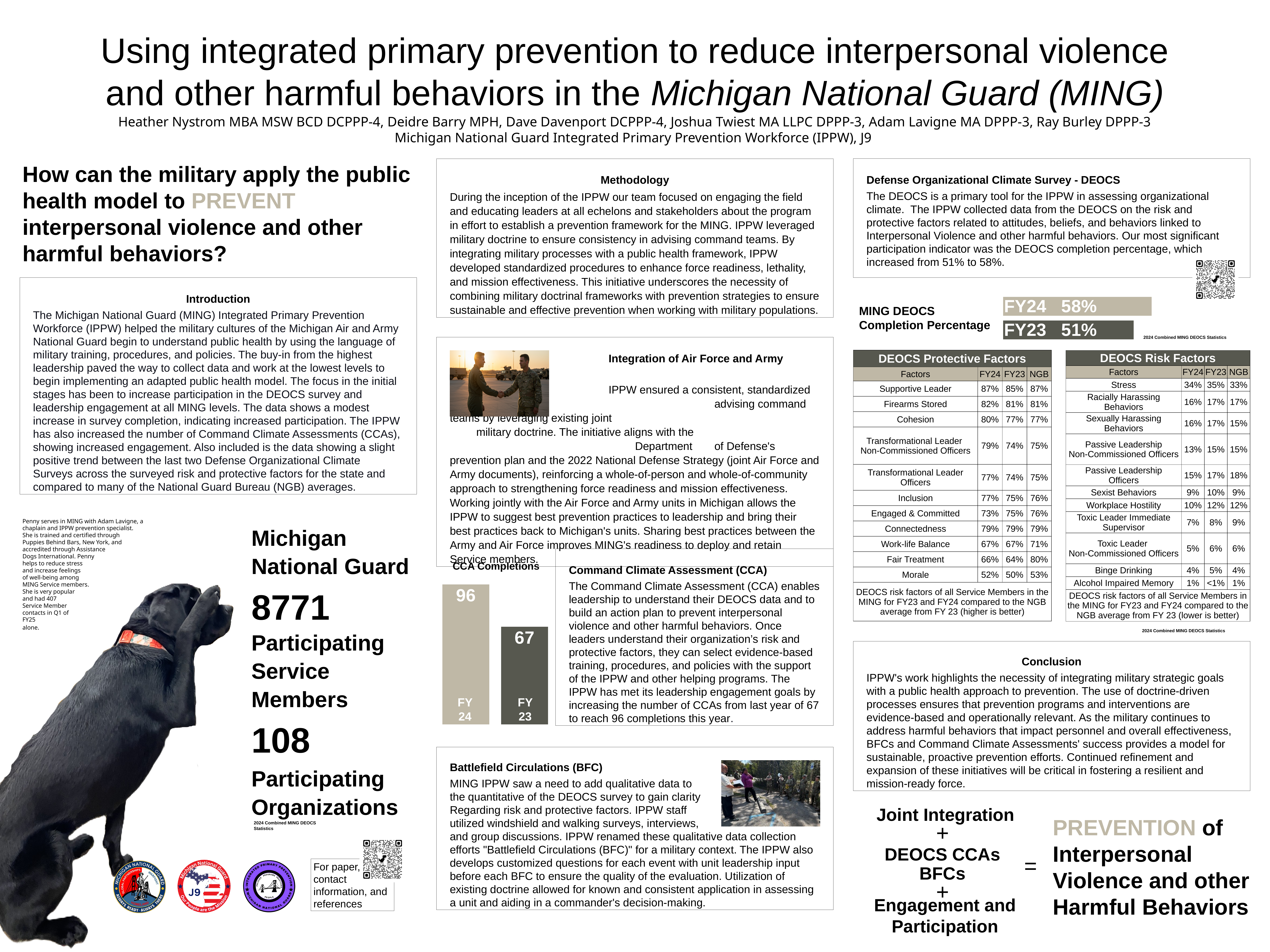
In the CCA Completions chart, which fiscal year has the lower number of completions? FY23 In the CCA Completions chart, what is the value for FY23? 67 In the MING DEOCS Completion Percentage chart, what is the difference between the FY24 and FY23 percentages? 7% In the CCA Completions chart, what is the difference between the FY24 and FY23 values? 29 In the CCA Completions chart, how many bars are shown? 2 In the MING DEOCS Completion Percentage chart, what is the value for FY23? 51% What kind of chart is the CCA Completions chart? bar chart In the MING DEOCS Completion Percentage chart, how many fiscal years are shown? 2 In the CCA Completions chart, what is the value for FY24? 96 In the CCA Completions chart, which fiscal year has the higher number of completions? FY24 In the MING DEOCS Completion Percentage chart, what is the value for FY24? 58% In the MING DEOCS Completion Percentage chart, which fiscal year has the higher completion percentage? FY24